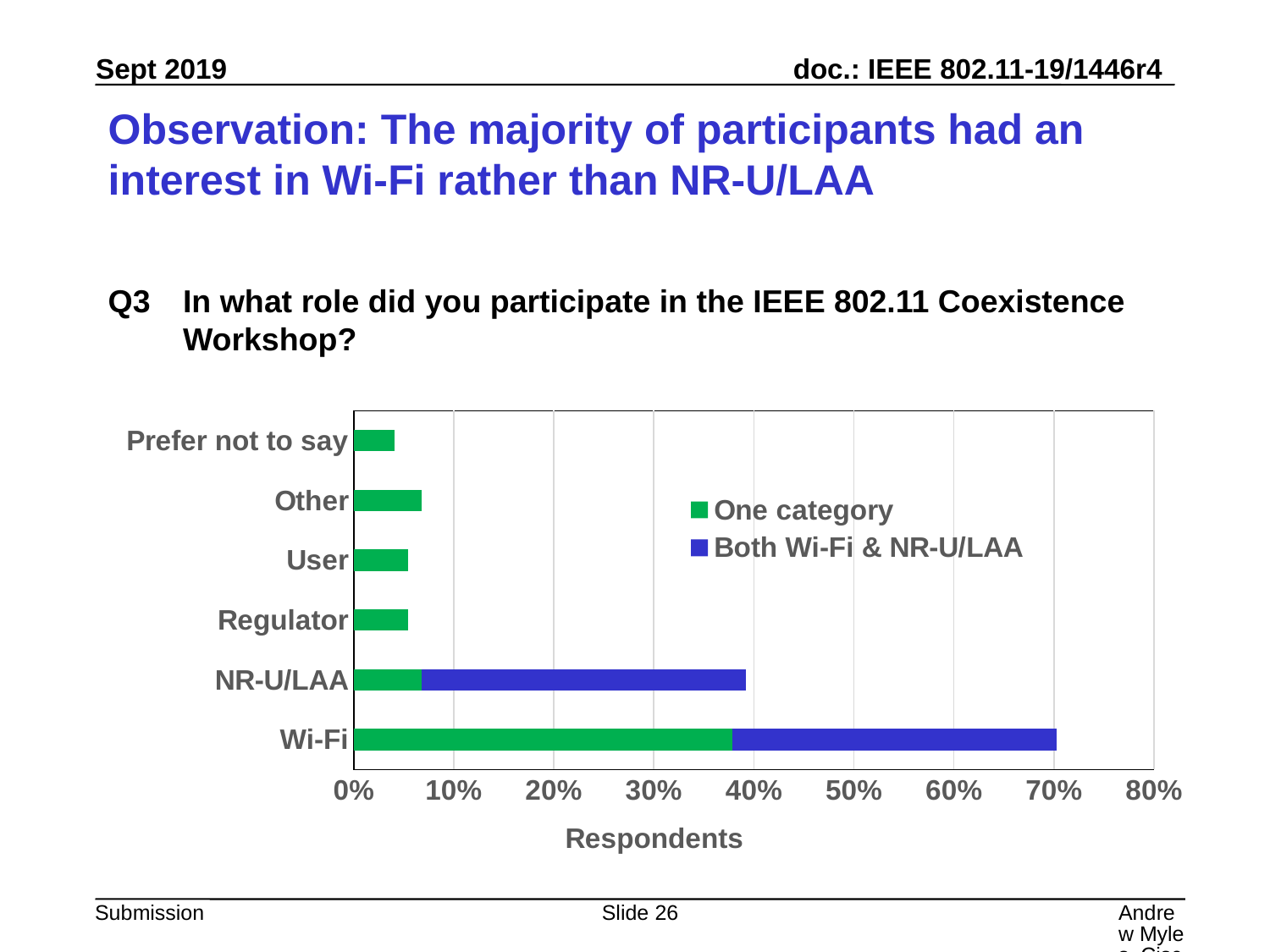
Is the total value for NR-U/LAA greater or less than 50%? less Which category has the shortest bar in the chart? Prefer not to say How many series does the chart's legend list? 2 What is the title of the chart's horizontal axis? Respondents Which has a longer total bar, Wi-Fi or NR-U/LAA? Wi-Fi How many categories are shown on the chart's vertical axis? 6 Which series is shown in blue in the chart's legend? Both Wi-Fi & NR-U/LAA Which category has the longest bar in the chart? Wi-Fi Which has a longer bar, Other or Prefer not to say? Other Is the total value for Wi-Fi greater or less than 60%? greater What kind of chart is shown on the slide? bar chart Is the value for Prefer not to say greater or less than 10%? less